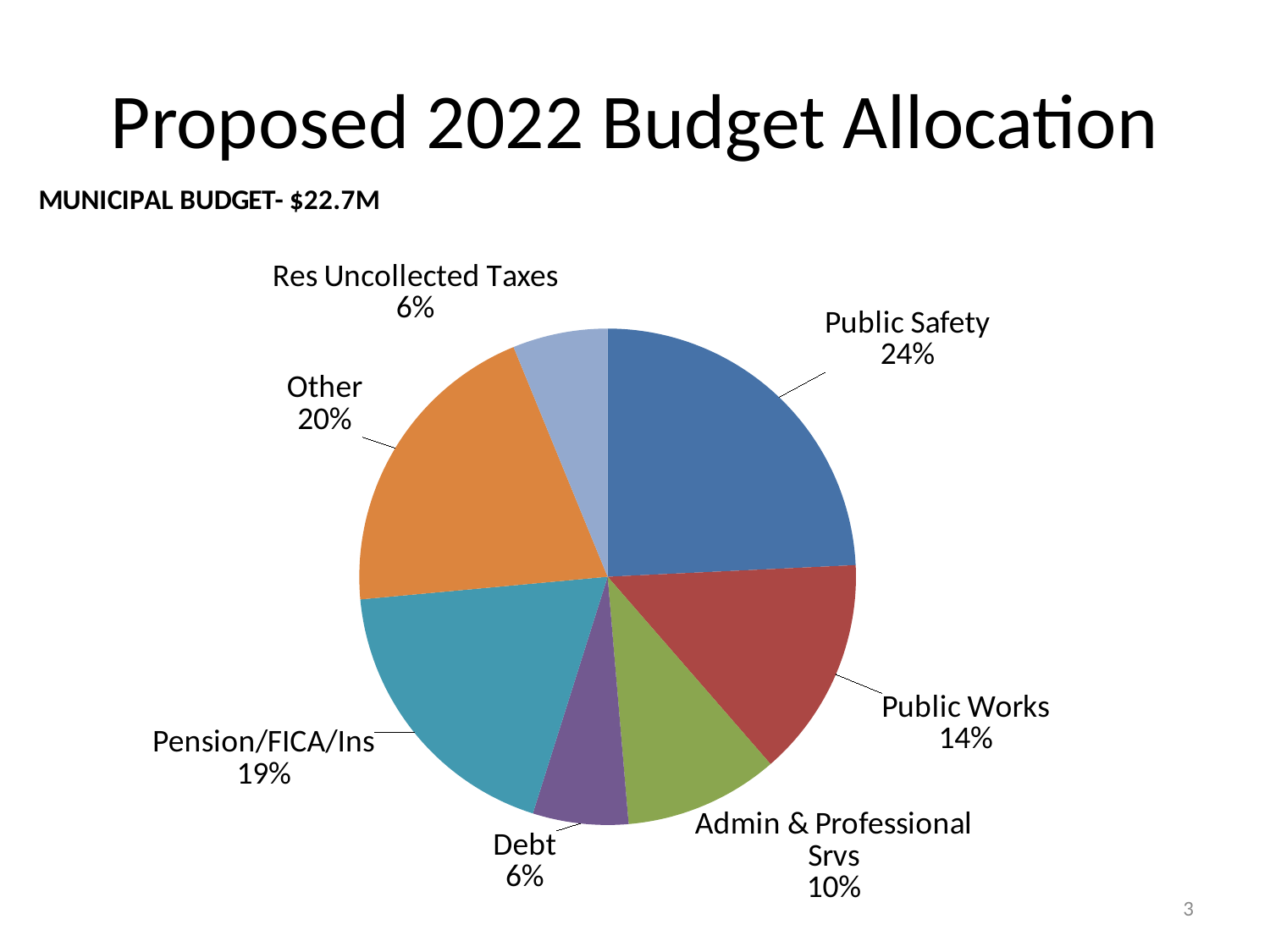
What is the combined share of Public Safety and Public Works? 38% Which category has the largest slice of the pie? Public Safety What share does Admin & Professional Srvs receive? 10% What is the difference in percentage points between Public Safety and Public Works? 10 Which is larger, Public Works or Admin & Professional Srvs? Public Works What share of the pie does Debt represent? 6% What share of the budget goes to Public Safety? 24% What kind of chart is shown on the slide? Pie chart How many categories are shown in the pie chart? 7 Which is larger, the share for Other or the share for Pension/FICA/Ins? Other What total municipal budget amount is stated on the slide? $22.7M What percentage is allocated to Pension/FICA/Ins? 19%